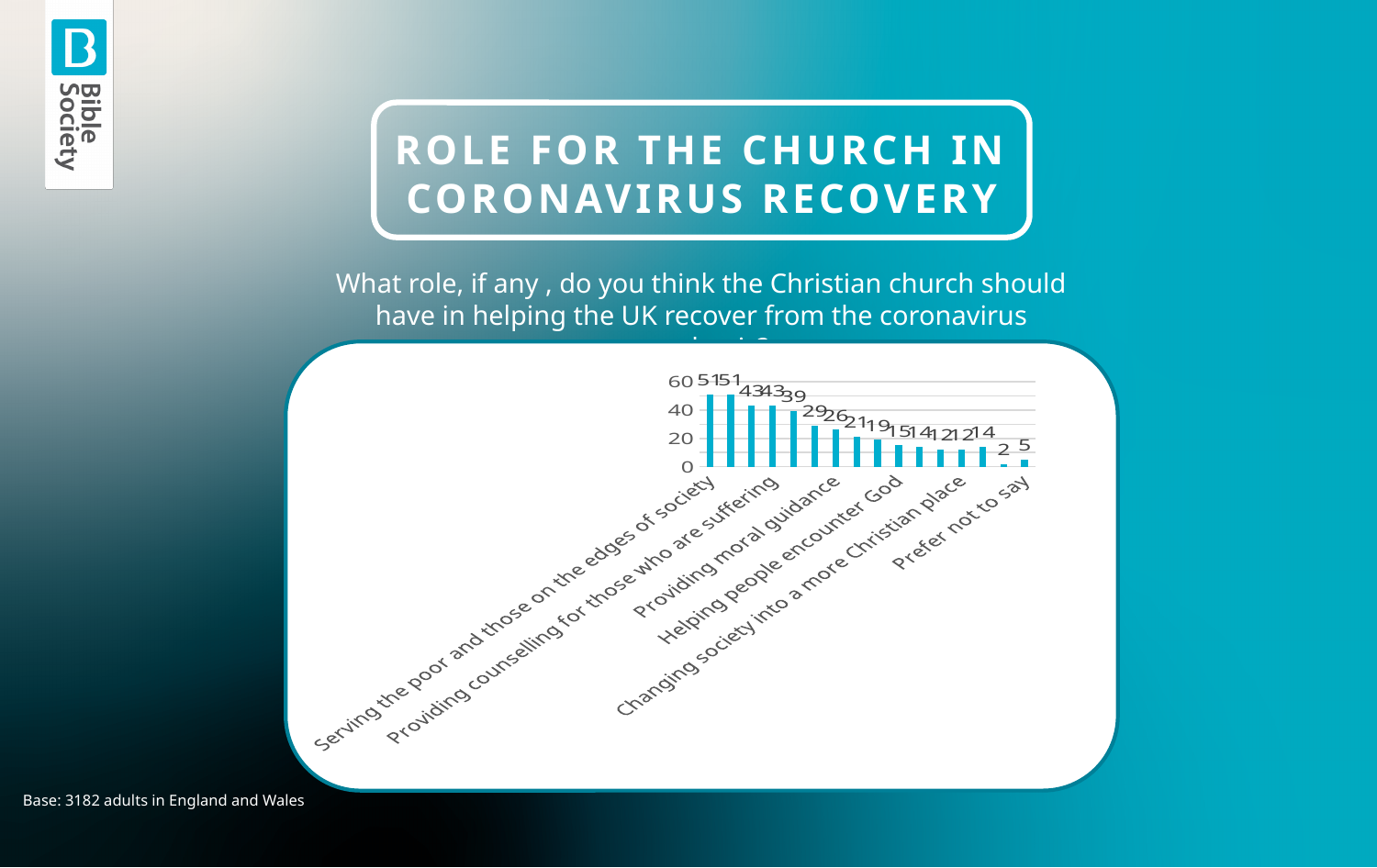
What is the highest value shown in the chart? 51 What is the highest tick value shown on the vertical axis? 60 What is the value for 'Prefer not to say'? 5 What kind of chart is shown on the slide? bar chart What is the difference between the value for 'Serving the poor and those on the edges of society' and the value for 'Prefer not to say'? 46 What is the value for 'Serving the poor and those on the edges of society'? 51 How many bars have a value of 51? 2 What is the lowest value shown in the chart? 2 Is the value for 'Serving the poor and those on the edges of society' greater or less than 40? greater Which is larger: the value for 'Serving the poor and those on the edges of society' or for 'Prefer not to say'? Serving the poor and those on the edges of society How many bars are plotted in the chart? 16 Do the values generally rise or fall from left to right across the chart? fall